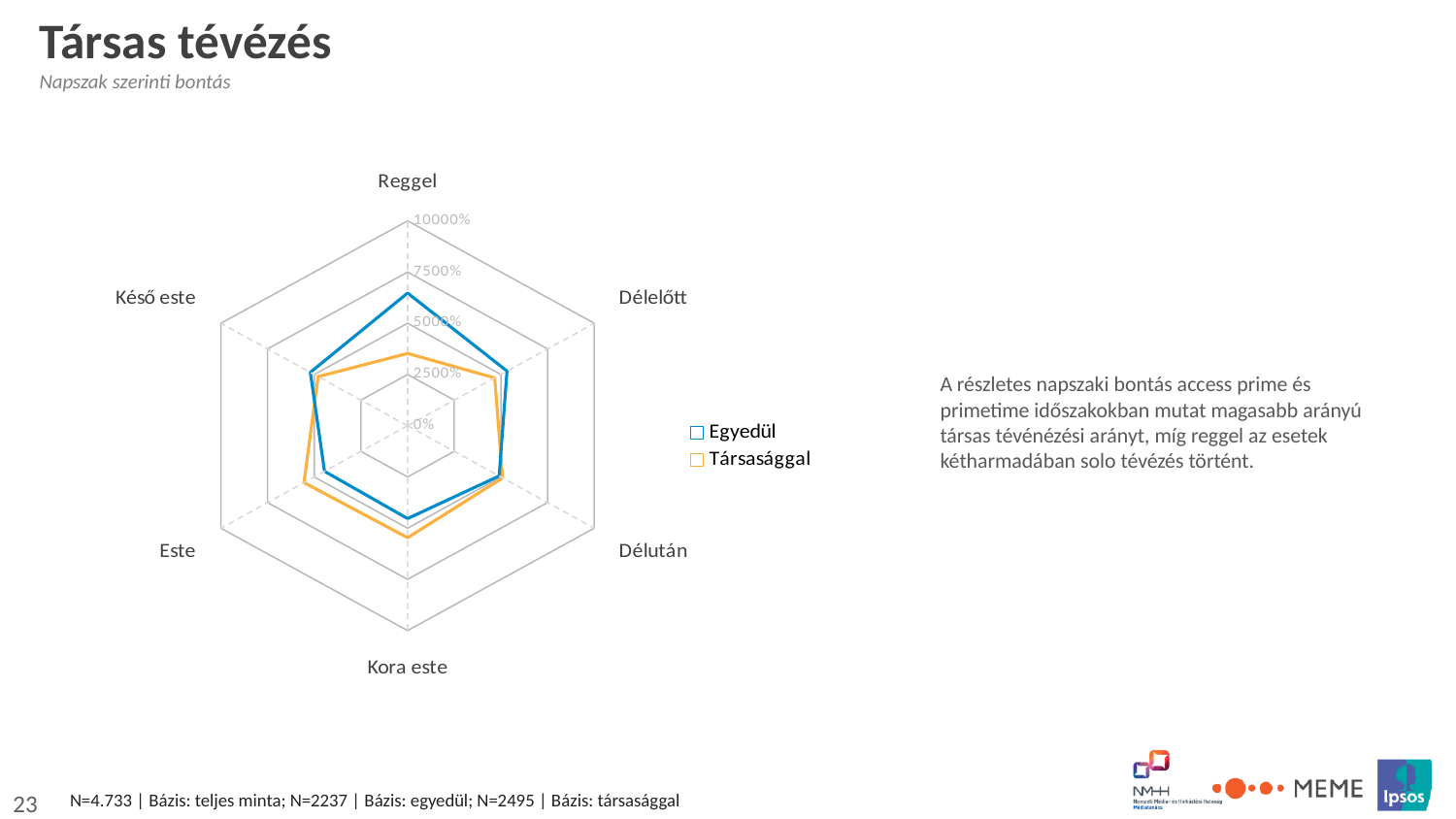
Which series is drawn in blue? Egyedül Is the Egyedül value for Reggel greater or less than 5000%? greater In which category does the Társasággal series have its lowest value? Reggel For Este, which series has the larger value, Egyedül or Társasággal? Társasággal Is the Társasággal value for Reggel greater or less than 5000%? less How many categories (times of day) does the radar chart have? 6 How many series does the legend list? 2 For Reggel, which series has the larger value, Egyedül or Társasággal? Egyedül What kind of chart is shown on the slide? Radar chart In which category does the Egyedül series reach its highest value? Reggel For Kora este, which series has the larger value, Egyedül or Társasággal? Társasággal What is the title of the slide containing the chart? Társas tévézés